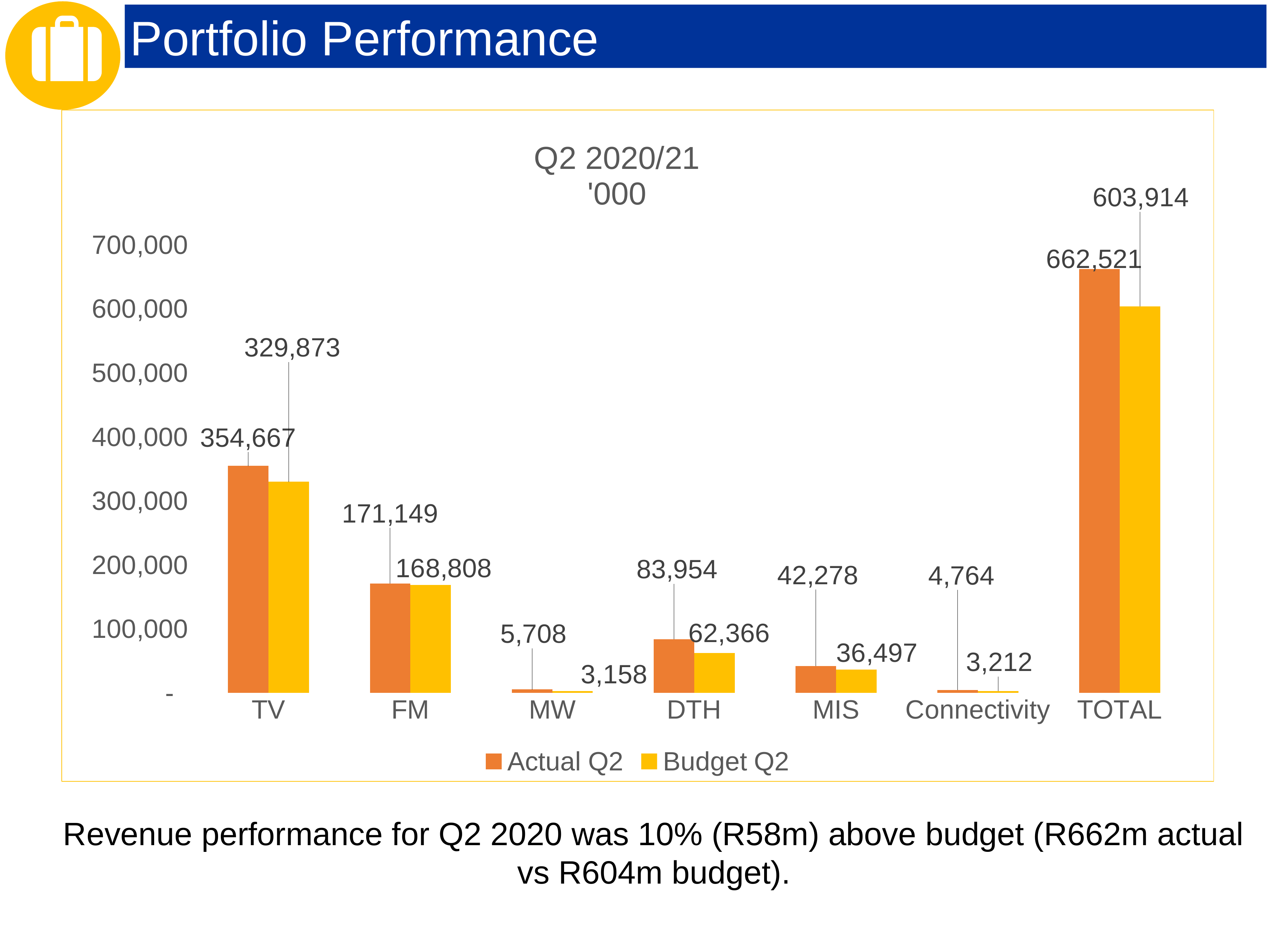
What is the Budget Q2 value for Connectivity? 3,212 What type of chart is shown on the slide? Bar chart What is the Actual Q2 value for TOTAL? 662,521 How many categories are shown on the x axis? 7 Excluding TOTAL, which category has the highest Actual Q2 value? TV Which is larger for DTH, the Actual Q2 value or the Budget Q2 value? Actual Q2 What is the difference between the Actual Q2 and Budget Q2 values for TV? 24,794 Which category has the lowest Budget Q2 value? MW How many series does the legend list? 2 What is the Actual Q2 value for TV? 354,667 What is the Budget Q2 value for DTH? 62,366 What is the difference between the Actual Q2 and Budget Q2 values for TOTAL? 58,607